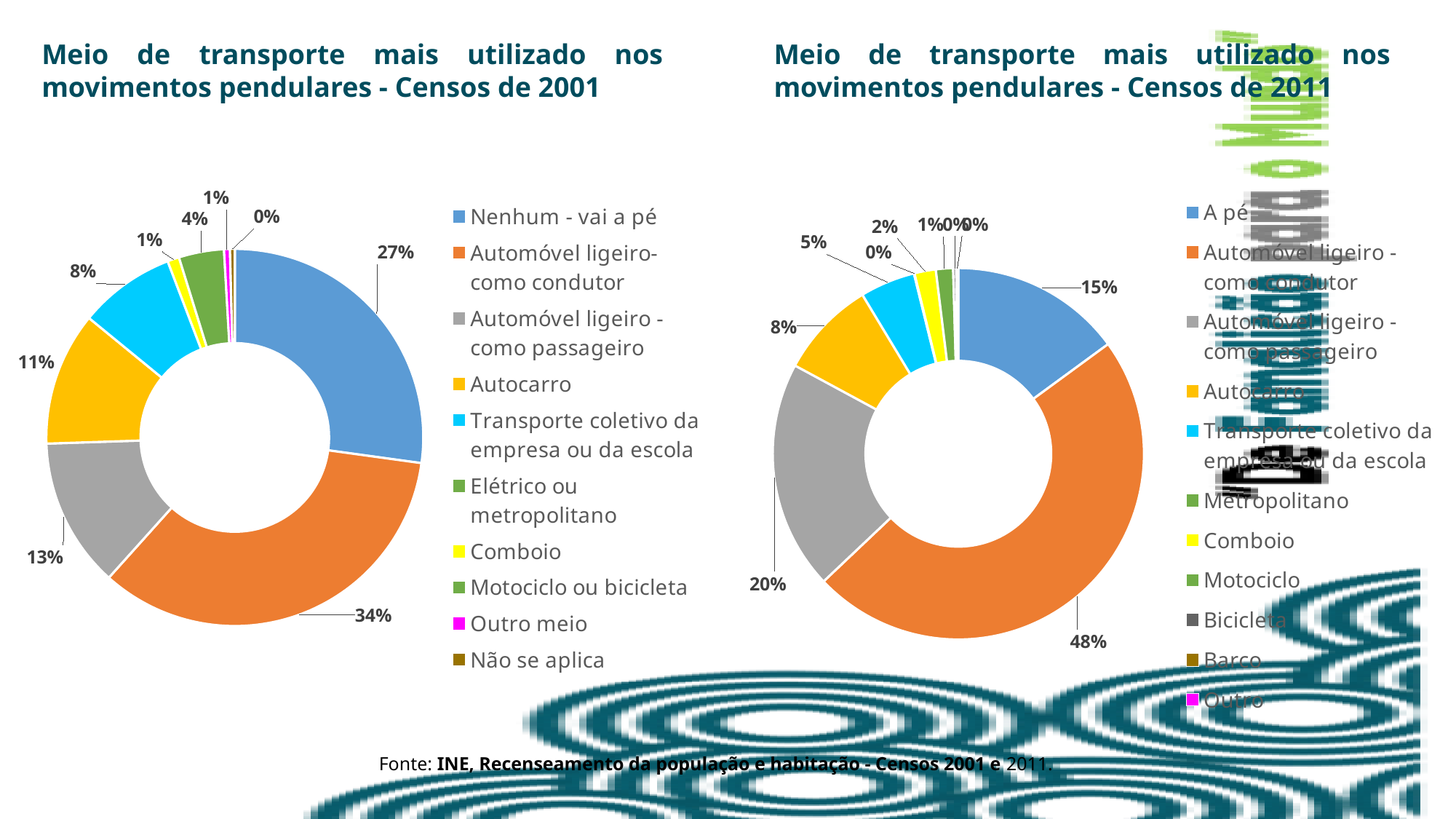
In the Censos de 2011 chart, what share is shown for 'Automóvel ligeiro - como condutor'? 48% In the Censos de 2011 chart, what share is shown for 'Automóvel ligeiro - como passageiro'? 20% How many entries does the legend of the Censos de 2011 chart list? 11 In the Censos de 2001 chart, which category has the largest share? Automóvel ligeiro - como condutor In the Censos de 2001 chart, what share is shown for 'Automóvel ligeiro - como condutor'? 34% In the Censos de 2001 chart, which is larger: the share for 'Automóvel ligeiro - como passageiro' or for 'Autocarro'? Automóvel ligeiro - como passageiro In the Censos de 2011 chart, what share is shown for 'A pé'? 15% What is the difference between the 'Automóvel ligeiro - como condutor' share in the Censos de 2011 chart and in the Censos de 2001 chart? 14 percentage points In the Censos de 2001 chart, what share is shown for 'Nenhum - vai a pé'? 27% What type of chart is used on this slide? Doughnut (pie) chart In the Censos de 2011 chart, which category has the largest share? Automóvel ligeiro - como condutor In the Censos de 2001 chart, what share is shown for 'Autocarro'? 11%